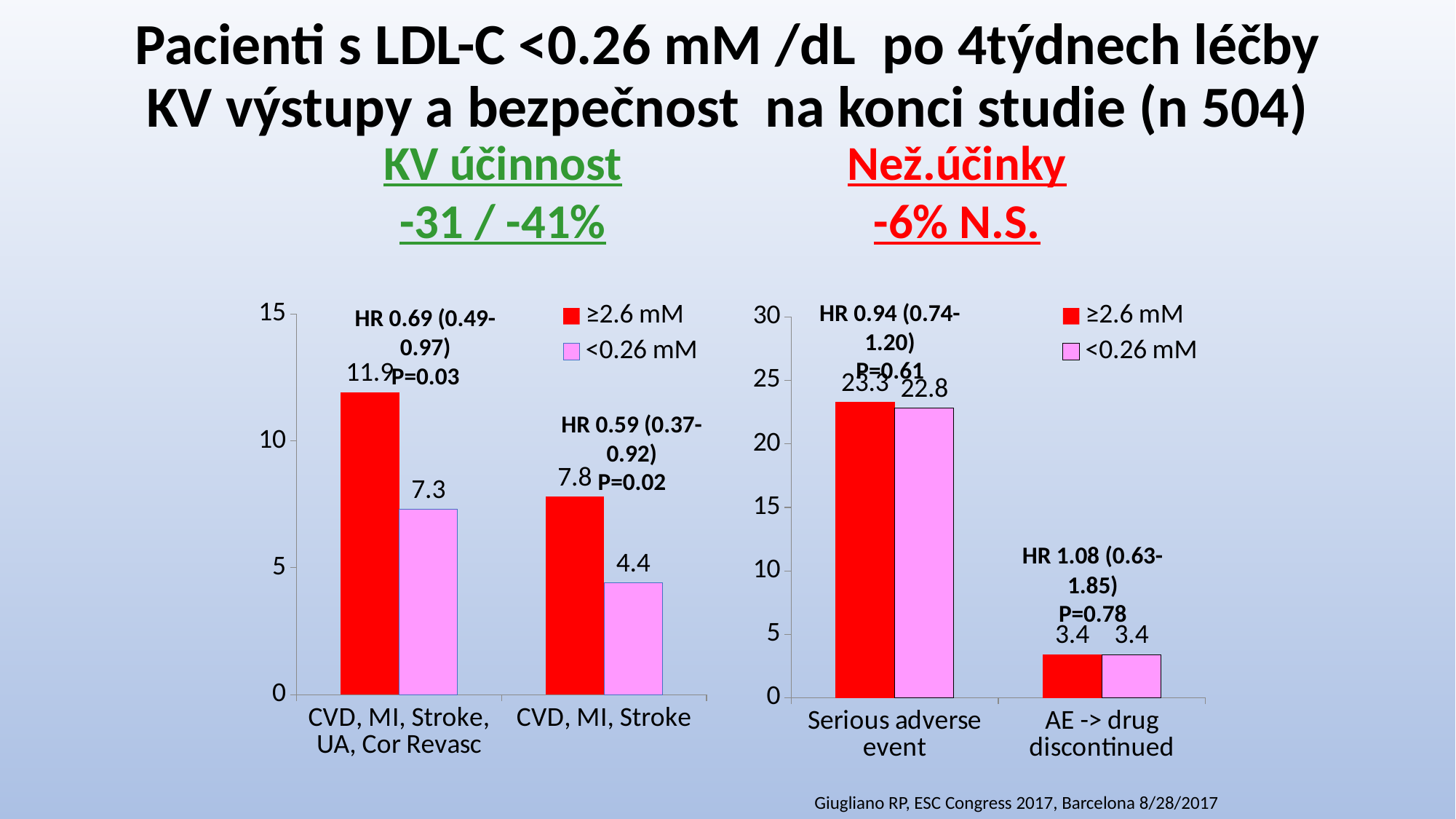
How many categories are shown on the x axis of the left chart? 2 In the right chart, what is the value for <0.26 mM in the 'Serious adverse event' category? 22.8 What type of chart is the right chart? Bar chart In the right chart, what is the value for ≥2.6 mM in the 'AE -> drug discontinued' category? 3.4 In the right chart, which category has the lowest values? AE -> drug discontinued In the left chart, which series has the larger value in the 'CVD, MI, Stroke' category, ≥2.6 mM or <0.26 mM? ≥2.6 mM How many series does the legend of the right chart list? 2 In the left chart, what is the difference between the ≥2.6 mM and <0.26 mM values in the 'CVD, MI, Stroke, UA, Cor Revasc' category? 4.6 In the left chart, which bar is the highest? ≥2.6 mM in CVD, MI, Stroke, UA, Cor Revasc In the left chart, what is the value for <0.26 mM in the 'CVD, MI, Stroke' category? 4.4 In the left chart, what is the value for ≥2.6 mM in the 'CVD, MI, Stroke, UA, Cor Revasc' category? 11.9 In the right chart, what is the difference between the ≥2.6 mM and <0.26 mM values for 'Serious adverse event'? 0.5